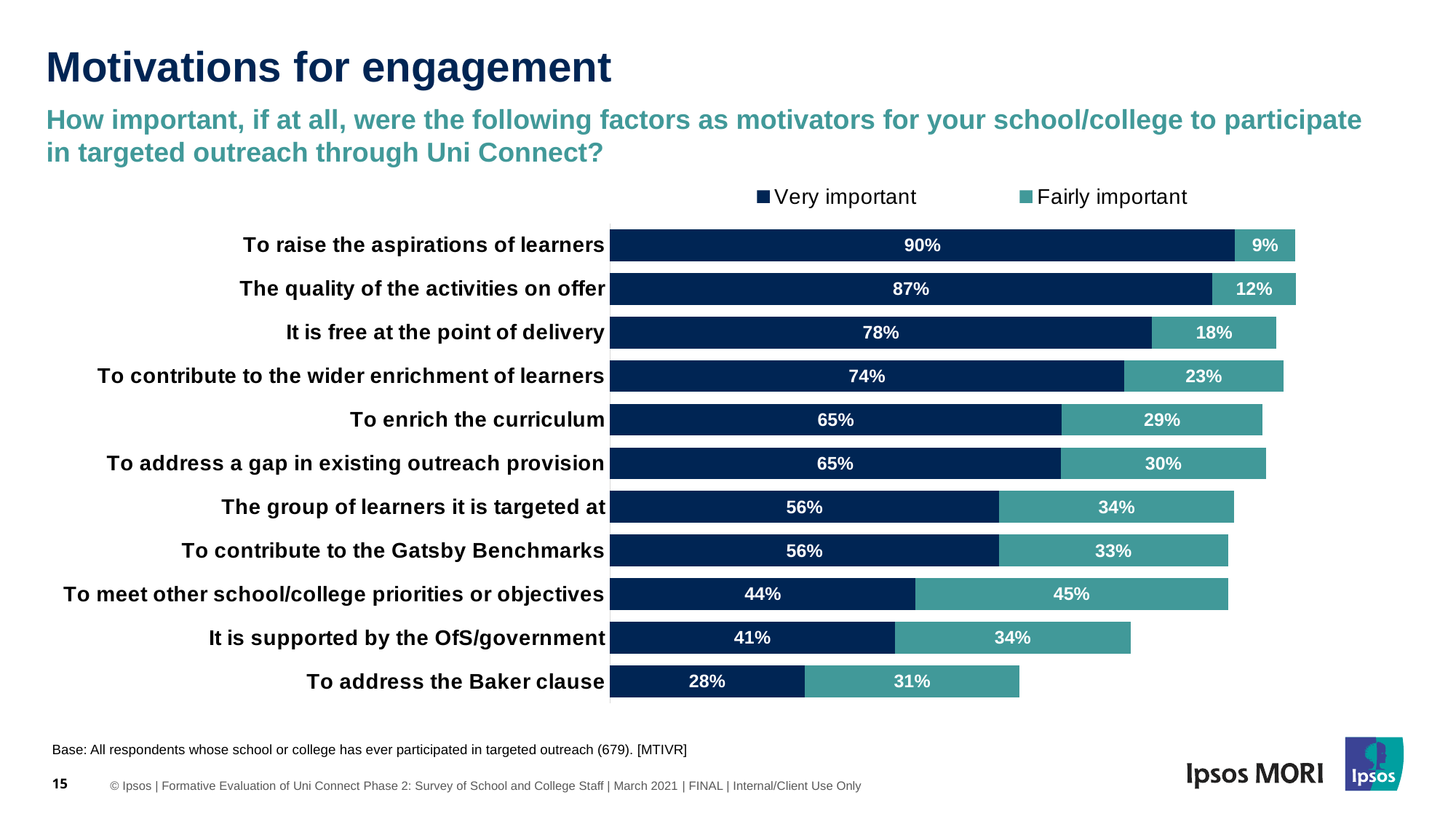
How many series does the legend list? 2 What percentage rated 'To address the Baker clause' as very important? 28% What is the difference between the 'Very important' percentages for 'The quality of the activities on offer' and 'It is free at the point of delivery'? 9% Which factor has the highest 'Fairly important' percentage? To meet other school/college priorities or objectives Which factor has the highest 'Very important' percentage? To raise the aspirations of learners How many factors are shown in the chart? 11 What type of chart is shown on the slide? Stacked bar chart What percentage rated 'It is free at the point of delivery' as fairly important? 18% What is the combined 'Very important' and 'Fairly important' percentage for 'To contribute to the wider enrichment of learners'? 97% Which has a larger 'Very important' percentage: 'To enrich the curriculum' or 'It is supported by the OfS/government'? To enrich the curriculum Which factor has the lowest 'Very important' percentage? To address the Baker clause What percentage rated 'To raise the aspirations of learners' as very important? 90%